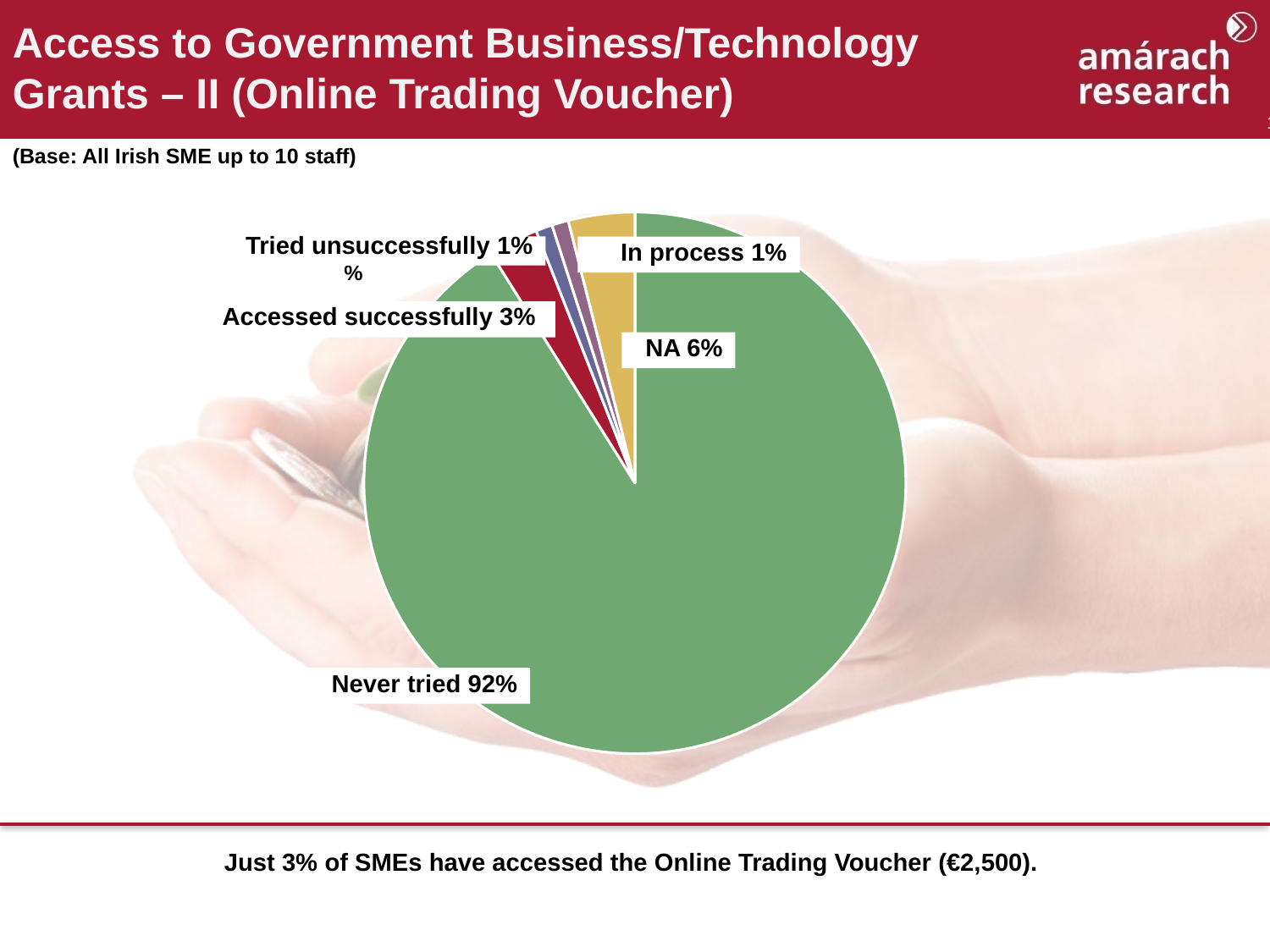
What is the difference between the Never tried share and the NA share? 86% What kind of chart is shown on the slide? pie chart What percentage of SMEs tried unsuccessfully to access the voucher? 1% What is the value of the NA slice? 6% Which is larger, the NA slice or the Accessed successfully slice? NA How many slices does the pie chart have? 5 What percentage of SMEs are in process of accessing the voucher? 1% What percentage of SMEs have never tried the Online Trading Voucher? 92% What percentage of SMEs accessed the Online Trading Voucher successfully? 3% What colour is the Never tried slice? green Which category has the largest share of the pie? Never tried What is the difference between the Accessed successfully share and the In process share? 2%